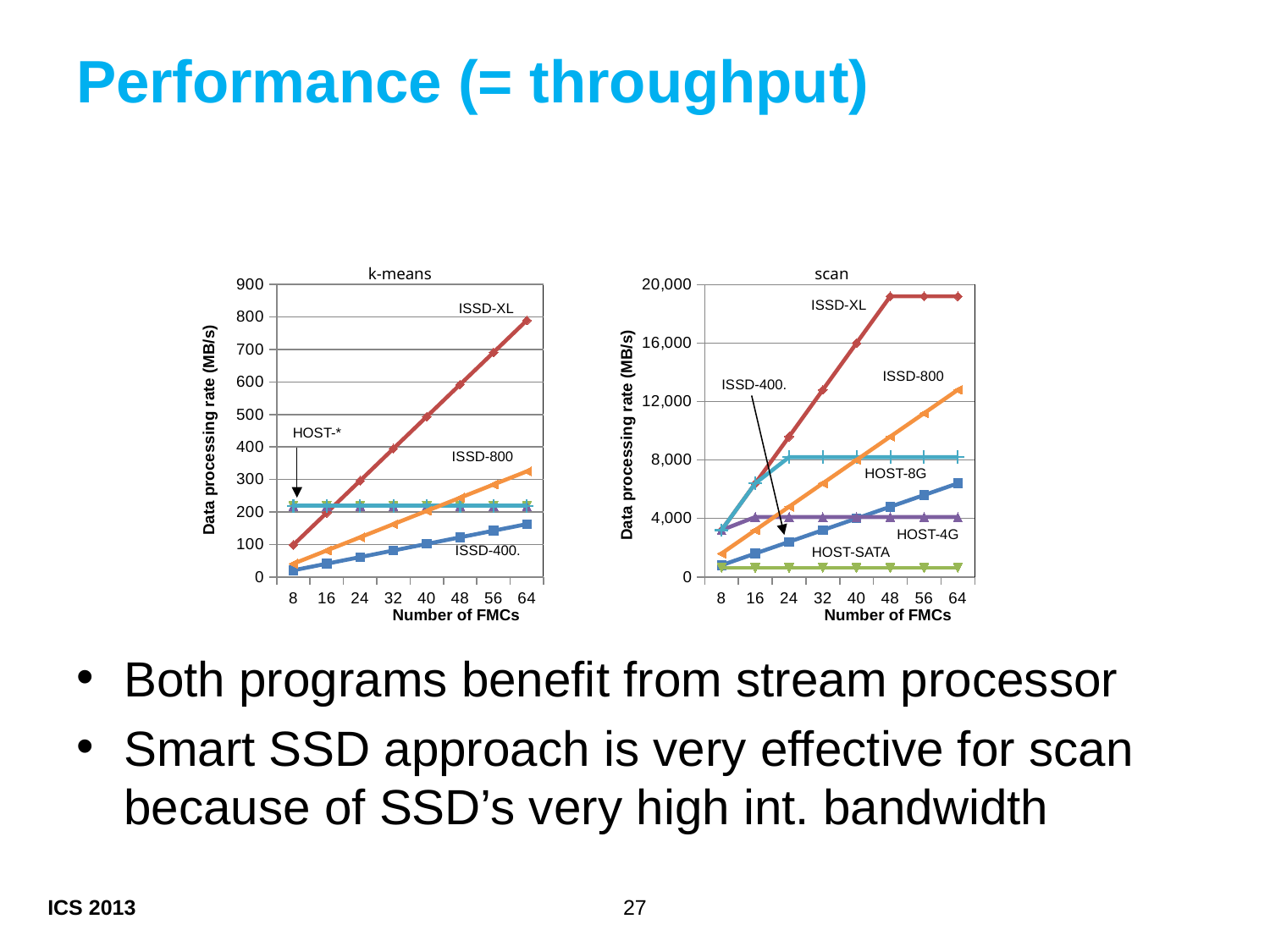
In the scan chart, is the ISSD-XL value at 64 FMCs greater or less than 16,000? greater How many x-axis points (numbers of FMCs) are plotted in the scan chart? 8 What kind of chart is the k-means chart? line chart In the scan chart, which series has the lowest data processing rate across all numbers of FMCs? HOST-SATA In the scan chart, is the HOST-SATA value at 64 FMCs greater or less than 4,000? less In the k-means chart, is the ISSD-400. value at 64 FMCs greater or less than 200? less In the k-means chart, which series has the highest data processing rate at 64 FMCs? ISSD-XL What is the y-axis label of the k-means chart? Data processing rate (MB/s) In the scan chart, how does the ISSD-800 data processing rate change as the number of FMCs increases from 8 to 64? rises In the scan chart, at 64 FMCs, which is larger: ISSD-800 or HOST-8G? ISSD-800 In the k-means chart, which series has the lowest data processing rate at 64 FMCs? ISSD-400.